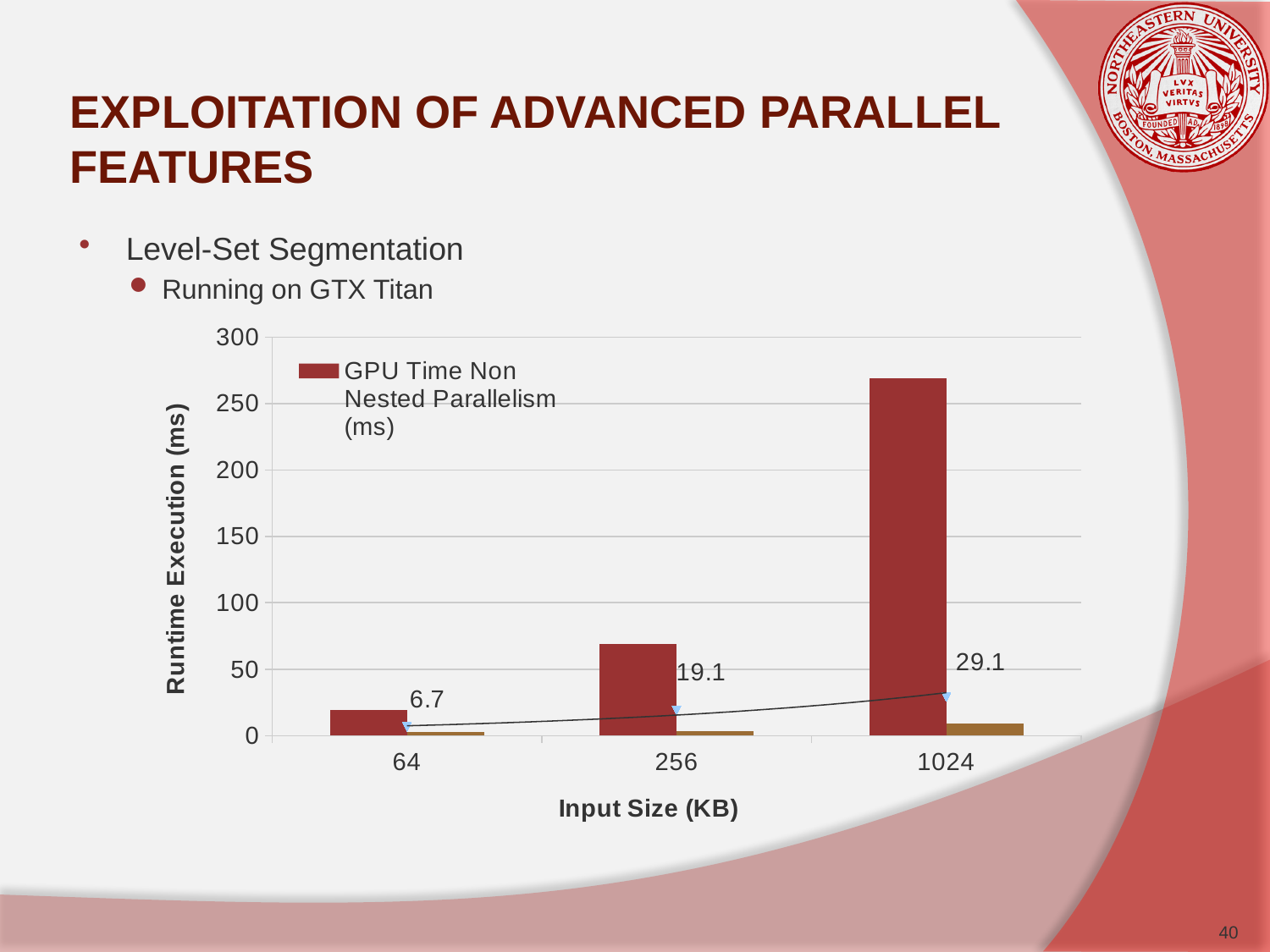
What is the title of the y axis? Runtime Execution (ms) What kind of chart is shown on the slide? bar chart How many series does the legend list? 1 What data label is printed at input size 64? 6.7 Is the GPU Time Non Nested Parallelism value for input size 1024 greater or less than 250? greater Is the GPU Time Non Nested Parallelism value for input size 64 greater or less than 50? less How many input size categories are shown on the x axis? 3 Which input size has the highest GPU Time Non Nested Parallelism bar? 1024 Which has the larger GPU Time Non Nested Parallelism bar, input size 256 or input size 64? 256 Which input size has the lowest GPU Time Non Nested Parallelism bar? 64 Is the GPU Time Non Nested Parallelism value for input size 256 greater or less than 100? less Do the GPU Time Non Nested Parallelism bars rise or fall as input size increases along the x axis? rise